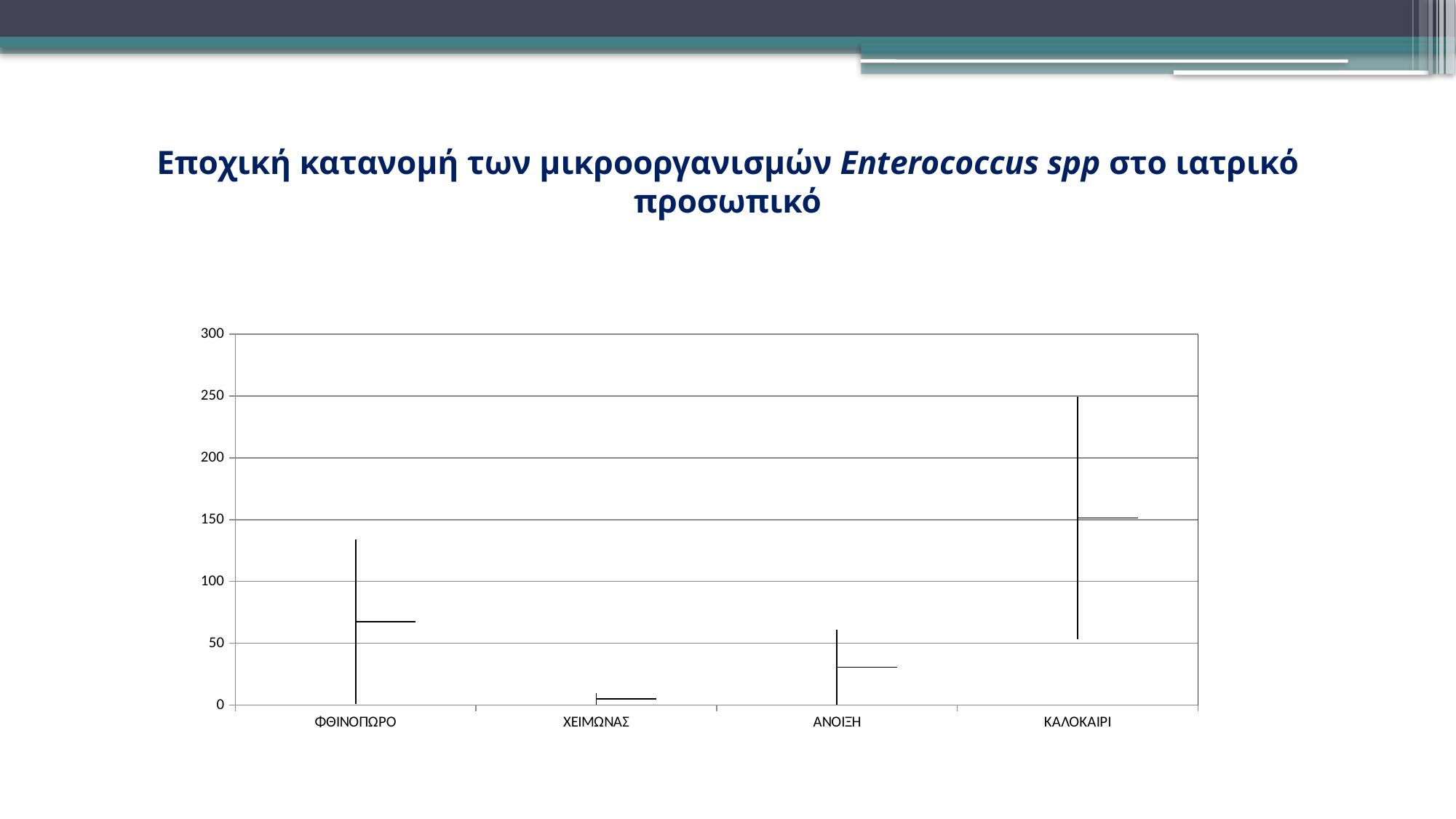
Is the top of the vertical line for ΑΝΟΙΞΗ greater or less than 100? less Which season has the highest values in the chart? ΚΑΛΟΚΑΙΡΙ Is the value for ΧΕΙΜΩΝΑΣ greater or less than 50? less What is the maximum value shown on the vertical axis of the chart? 300 Which microorganism is named in the slide title? Enterococcus spp Is the top of the vertical line for ΚΑΛΟΚΑΙΡΙ greater or less than 200? greater Which has the larger horizontal marker value, ΦΘΙΝΟΠΩΡΟ or ΑΝΟΙΞΗ? ΦΘΙΝΟΠΩΡΟ Which has the larger horizontal marker value, ΚΑΛΟΚΑΙΡΙ or ΦΘΙΝΟΠΩΡΟ? ΚΑΛΟΚΑΙΡΙ Which season has the lowest values in the chart? ΧΕΙΜΩΝΑΣ How many seasons (categories) are shown on the x axis of the chart? 4